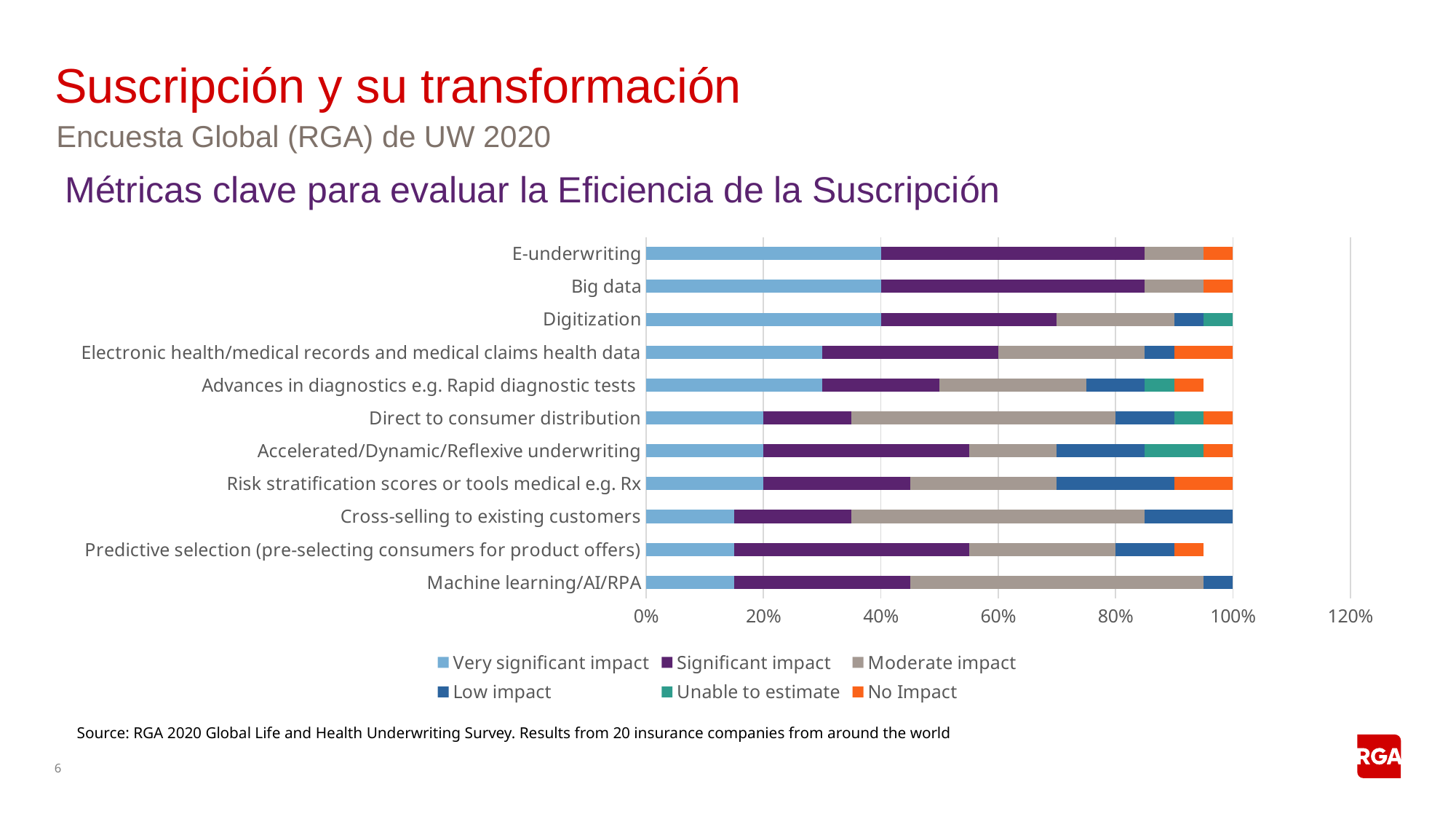
Is the total length of the bar for Advances in diagnostics e.g. Rapid diagnostic tests greater or less than 100%? less Which legend entry is shown in orange? No Impact Is the 'Very significant impact' value for Machine learning/AI/RPA greater or less than 20%? less Which has a larger 'Very significant impact' value: E-underwriting or Machine learning/AI/RPA? E-underwriting What is the 'Very significant impact' value for E-underwriting? 40% Is the 'Very significant impact' value for Electronic health/medical records and medical claims health data greater or less than 20%? greater How many series does the legend list? 6 How many categories are plotted on the chart? 11 What is the 'Very significant impact' value for Direct to consumer distribution? 20% Which has a larger 'Moderate impact' segment: Machine learning/AI/RPA or Big data? Machine learning/AI/RPA What kind of chart is shown on the slide? Stacked bar chart What is the title shown above the chart? Métricas clave para evaluar la Eficiencia de la Suscripción